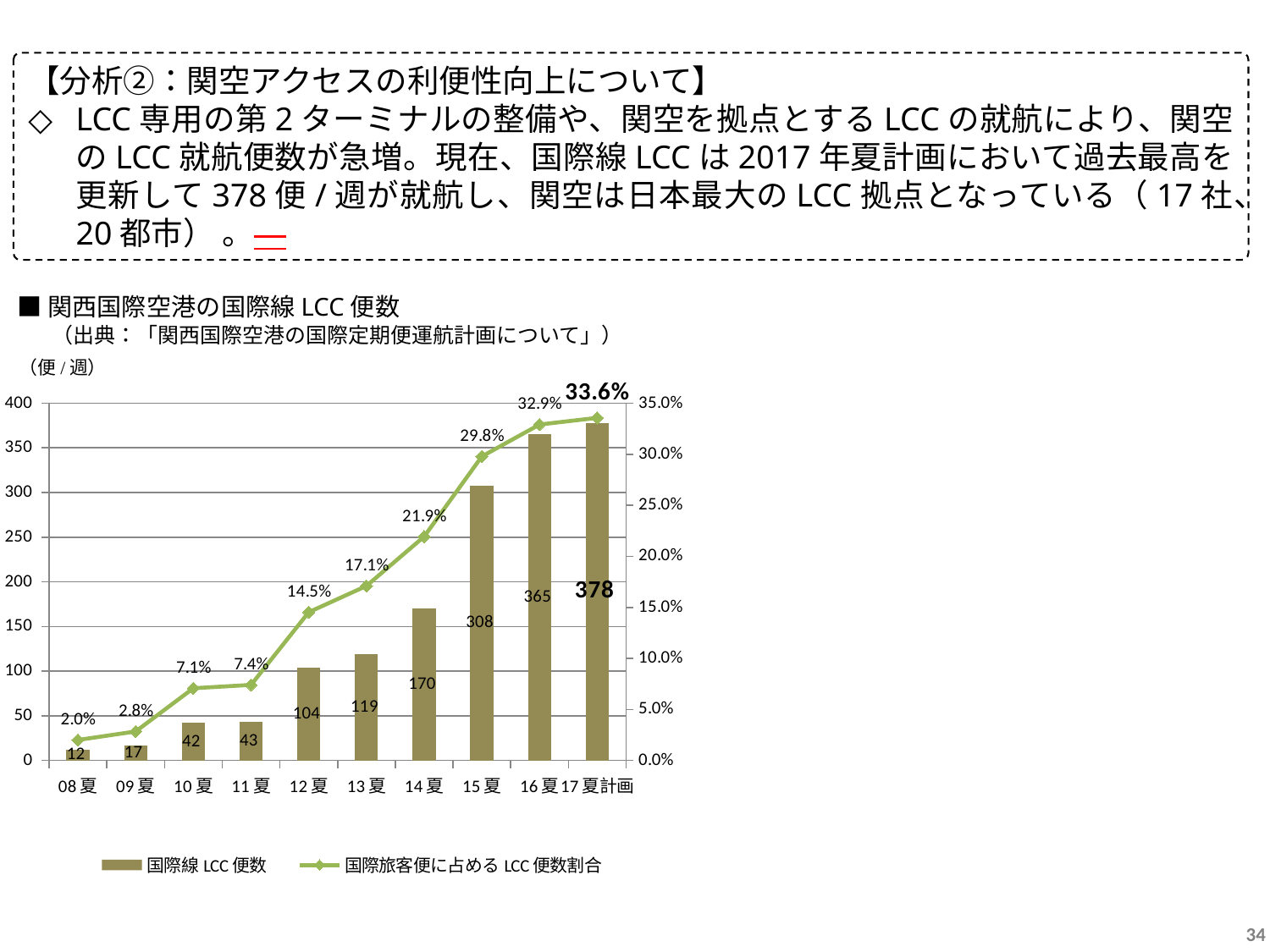
Which category has the highest 国際線LCC便数? 17夏計画 What is the 国際旅客便に占めるLCC便数割合 for 08夏? 2.0% What is the difference in 国際線LCC便数 between 16夏 and 15夏? 57 What is the value of 国際線LCC便数 for 17夏計画? 378 How many series does the legend list? 2 What is the value of 国際線LCC便数 for 15夏? 308 What kind of chart is shown on the slide? Combined bar and line chart Which is larger, the 国際線LCC便数 for 13夏 or for 12夏? 13夏 What is the 国際旅客便に占めるLCC便数割合 for 14夏? 21.9% How many categories are shown on the x axis of the chart? 10 Which category has the lowest 国際線LCC便数? 08夏 Does the 国際旅客便に占めるLCC便数割合 rise or fall from 08夏 to 17夏計画? Rise